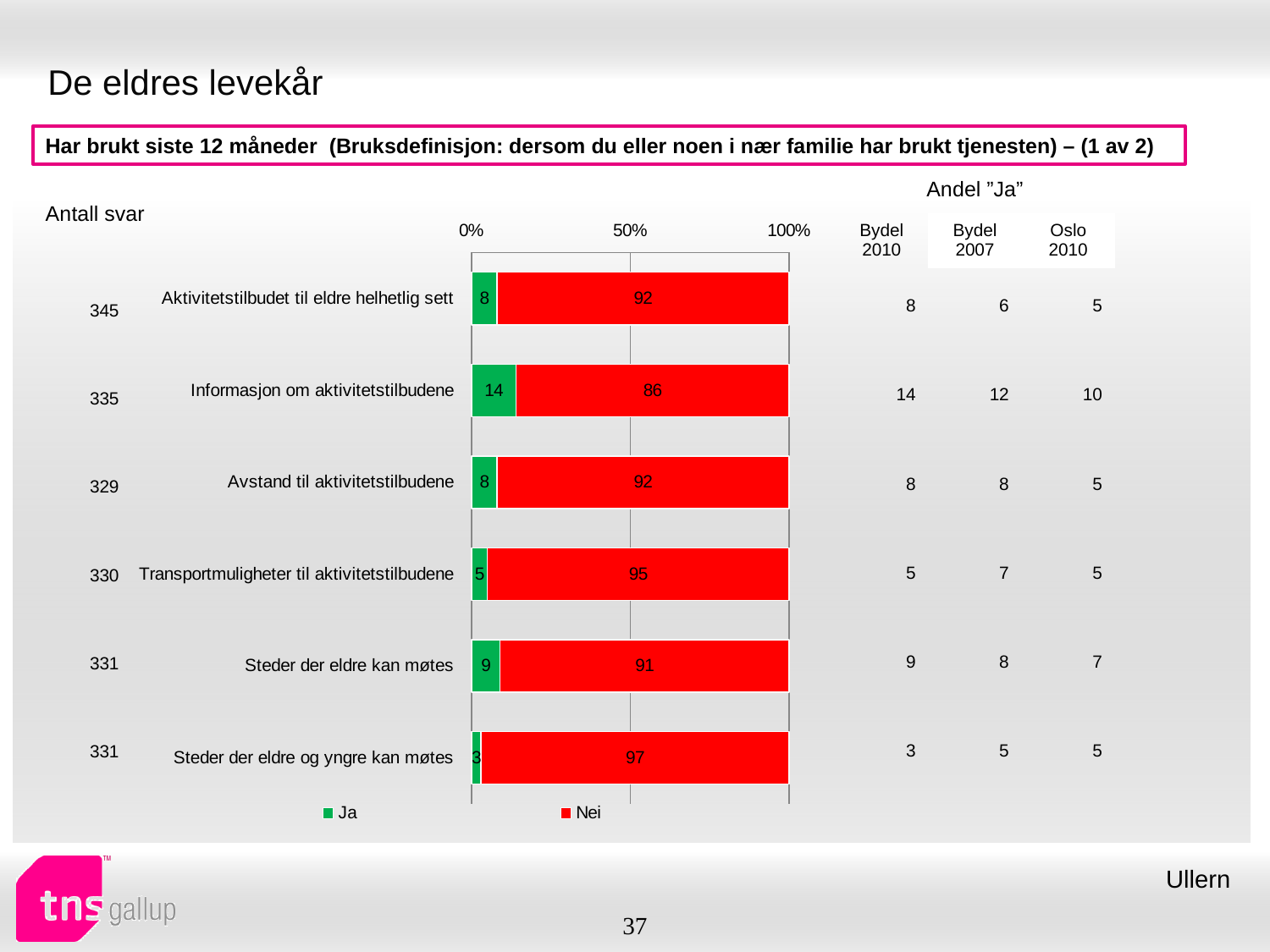
How many categories are shown in the chart? 6 Which category has the lowest "Ja" value? Steder der eldre og yngre kan møtes Which category has the highest "Ja" value? Informasjon om aktivitetstilbudene Which is larger: the "Ja" value for "Steder der eldre kan møtes" or for "Transportmuligheter til aktivitetstilbudene"? Steder der eldre kan møtes What is the "Nei" value for "Informasjon om aktivitetstilbudene"? 86 How many series does the legend list? 2 What kind of chart is shown on the slide? Stacked bar chart What is the "Ja" value for "Steder der eldre kan møtes"? 9 What is the difference between the "Nei" values for "Steder der eldre og yngre kan møtes" and "Informasjon om aktivitetstilbudene"? 11 Which colour represents "Nei" in the chart? Red What is the "Nei" value for "Transportmuligheter til aktivitetstilbudene"? 95 Is the "Nei" value for "Aktivitetstilbudet til eldre helhetlig sett" greater or less than 50%? greater